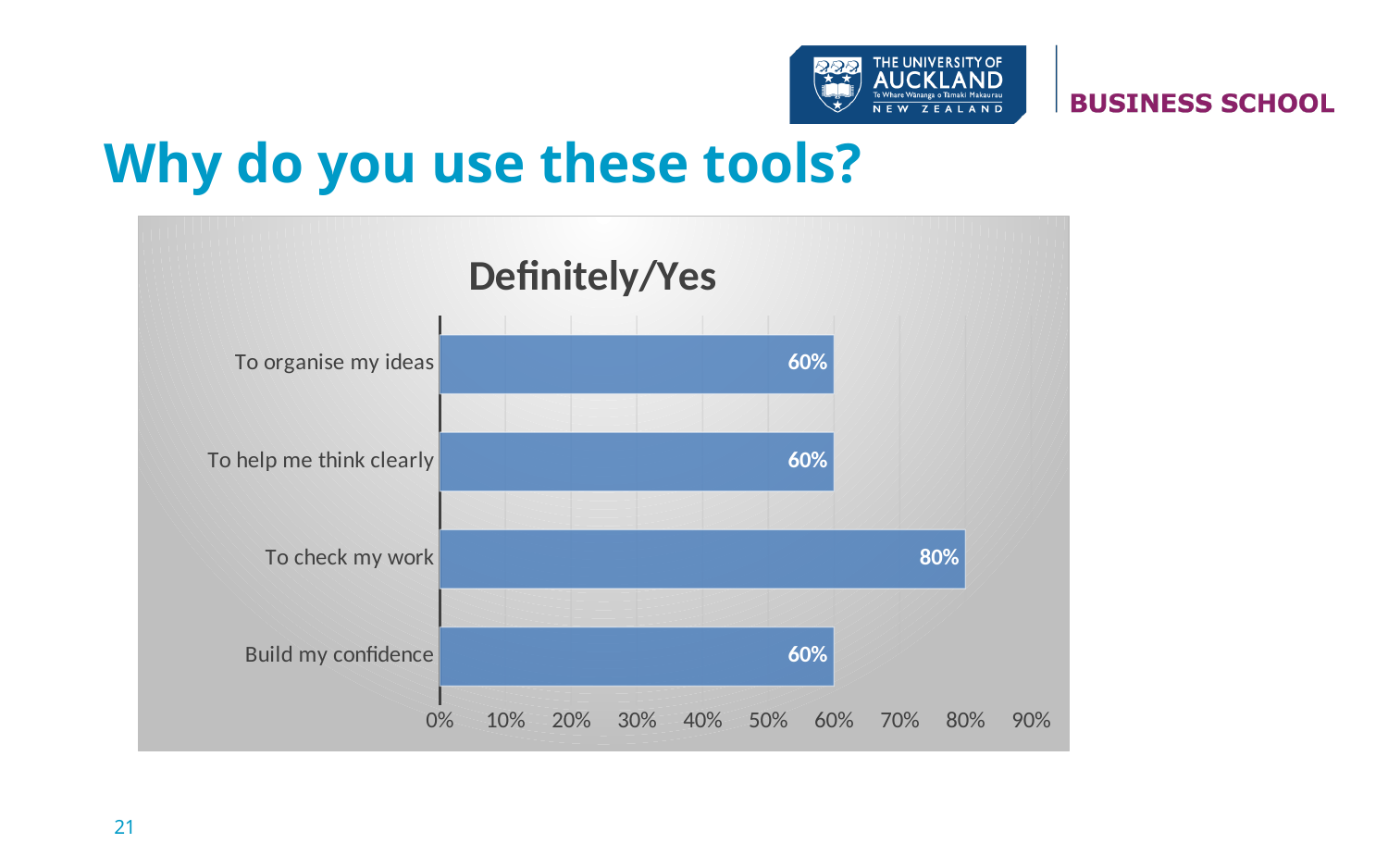
What is the value for "To check my work"? 80% What is the value for "To organise my ideas"? 60% What is the value for "Build my confidence"? 60% How many categories are shown in the chart? 4 Is the value for "To check my work" greater or less than 70%? greater What is the highest value shown on the x axis? 90% Which category has the highest value? To check my work What is the difference between the values for "To check my work" and "Build my confidence"? 20% Which is larger, the value for "To check my work" or the value for "To organise my ideas"? To check my work What is the value for "To help me think clearly"? 60% What is the title of the chart? Definitely/Yes What kind of chart is shown on the slide? Bar chart